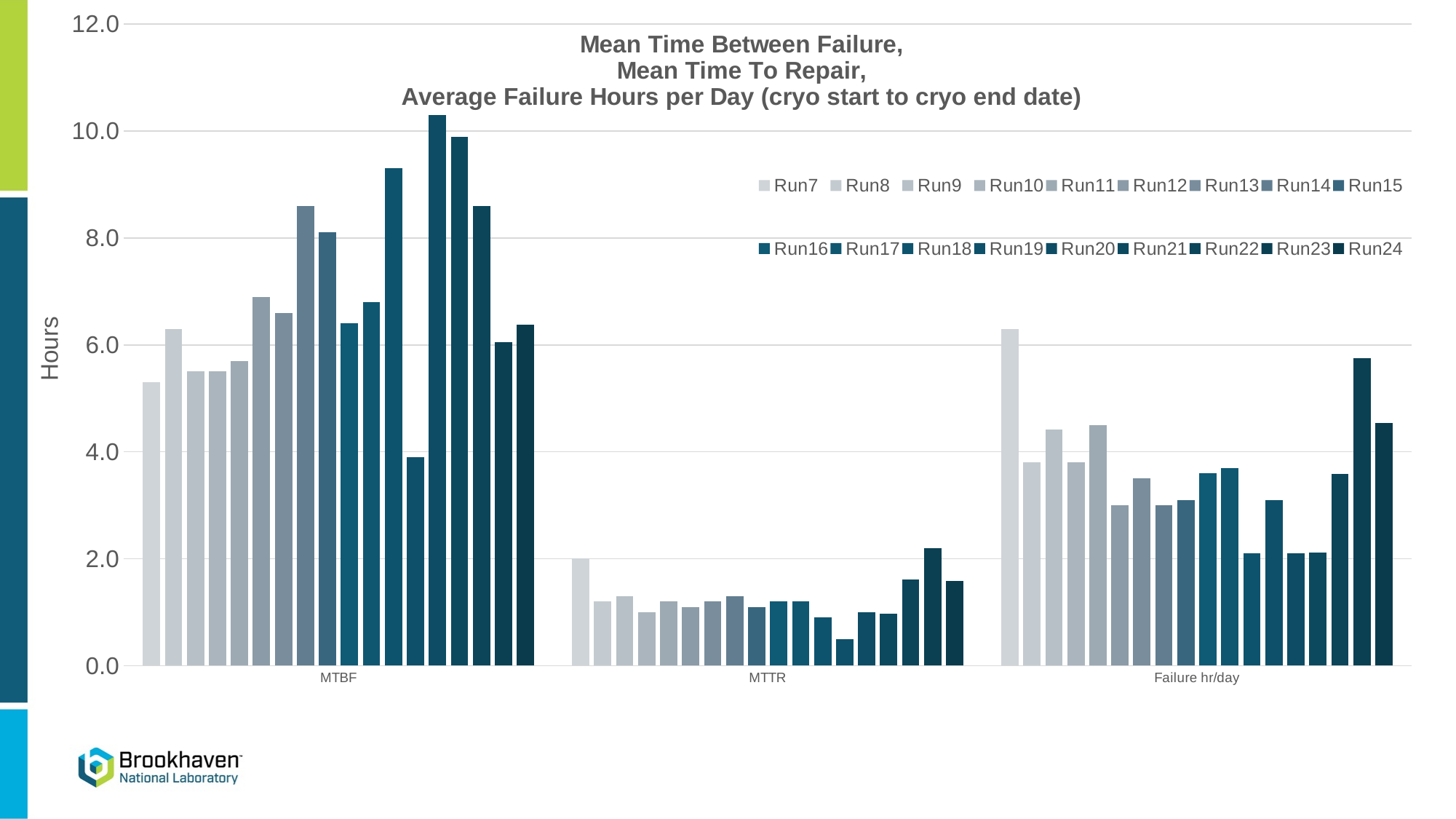
Is the Run7 value for MTTR greater or less than 1.0? greater How many categories are shown on the x axis? 3 Is the Run24 value for MTTR greater or less than 2.0? less What kind of chart is shown on the slide? bar chart Is the tallest bar in the MTBF category greater or less than 10.0? greater Which category contains the tallest bar in the chart? MTBF What is the highest value shown on the y axis? 12.0 How many series does the legend list? 18 What is the label of the y axis? Hours Which category has the lowest bars overall? MTTR